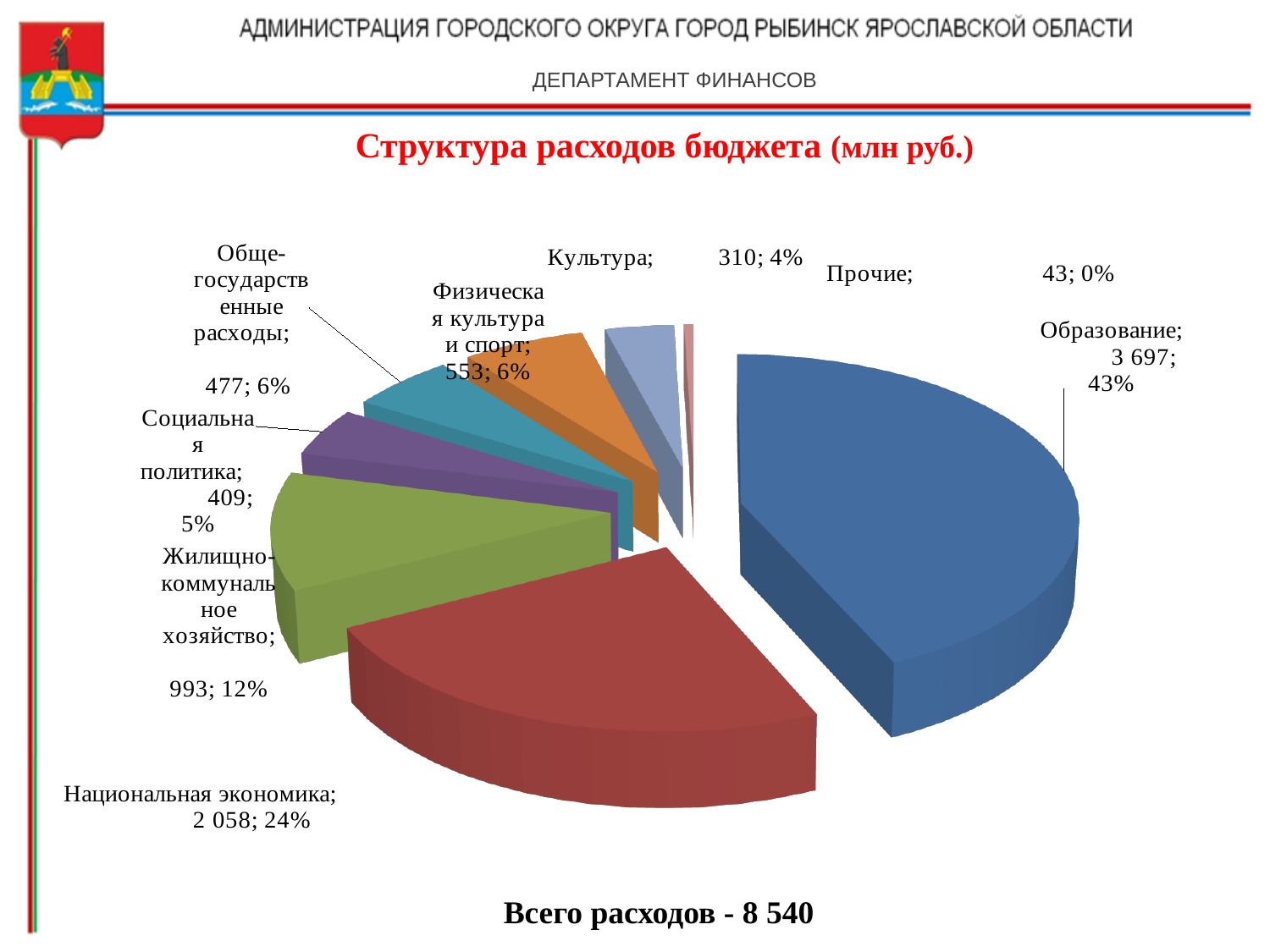
What is the value for Культура? 310 What share of the pie does Национальная экономика represent? 24% What share of the pie does Социальная политика represent? 5% Which category has the largest slice of the pie? Образование What is the value for Жилищно-коммунальное хозяйство? 993 Which category has the smallest slice of the pie? Прочие What kind of chart is shown on the slide? pie chart Which is larger, the value for Физическая культура и спорт or the value for Общегосударственные расходы? Физическая культура и спорт What is the value for Национальная экономика? 2 058 What is the value for Образование? 3 697 What is the difference between the values for Образование and Национальная экономика? 1 639 How many categories are shown in the pie chart? 8